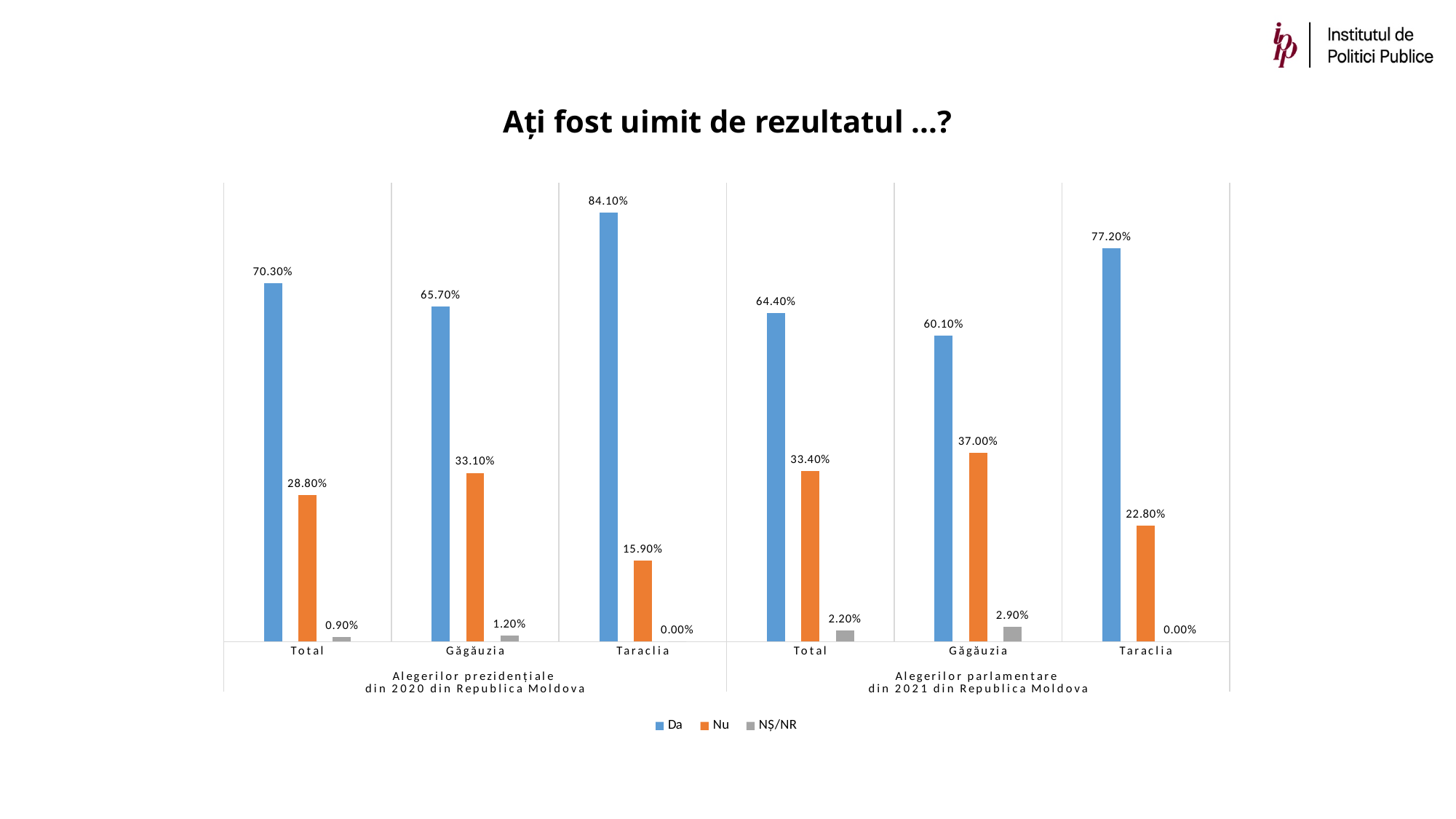
How many category groups are shown along the x axis? 6 Which category has the highest "Da" value across the whole chart? Taraclia (Alegerilor prezidențiale din 2020) Which is larger: the "Nu" value for Găgăuzia in the 2020 presidential elections or the "Nu" value for Găgăuzia in the 2021 parliamentary elections? Găgăuzia in the 2021 parliamentary elections (37.00%) What is the value of "Da" for Taraclia under "Alegerilor prezidențiale din 2020 din Republica Moldova"? 84.10% What is the value of "Nu" for Găgăuzia under "Alegerilor parlamentare din 2021 din Republica Moldova"? 37.00% What is the difference between the "Da" values for Total in the 2020 presidential elections and Total in the 2021 parliamentary elections? 5.90% What is the value of "NȘ/NR" for Total under "Alegerilor parlamentare din 2021 din Republica Moldova"? 2.20% Which colour represents the "Nu" series in the legend? Orange What is the title of the chart? Ați fost uimit de rezultatul ...? What kind of chart is shown on the slide? Bar chart Which category has the lowest "Nu" value across the whole chart? Taraclia (Alegerilor prezidențiale din 2020) How many series does the legend list? 3